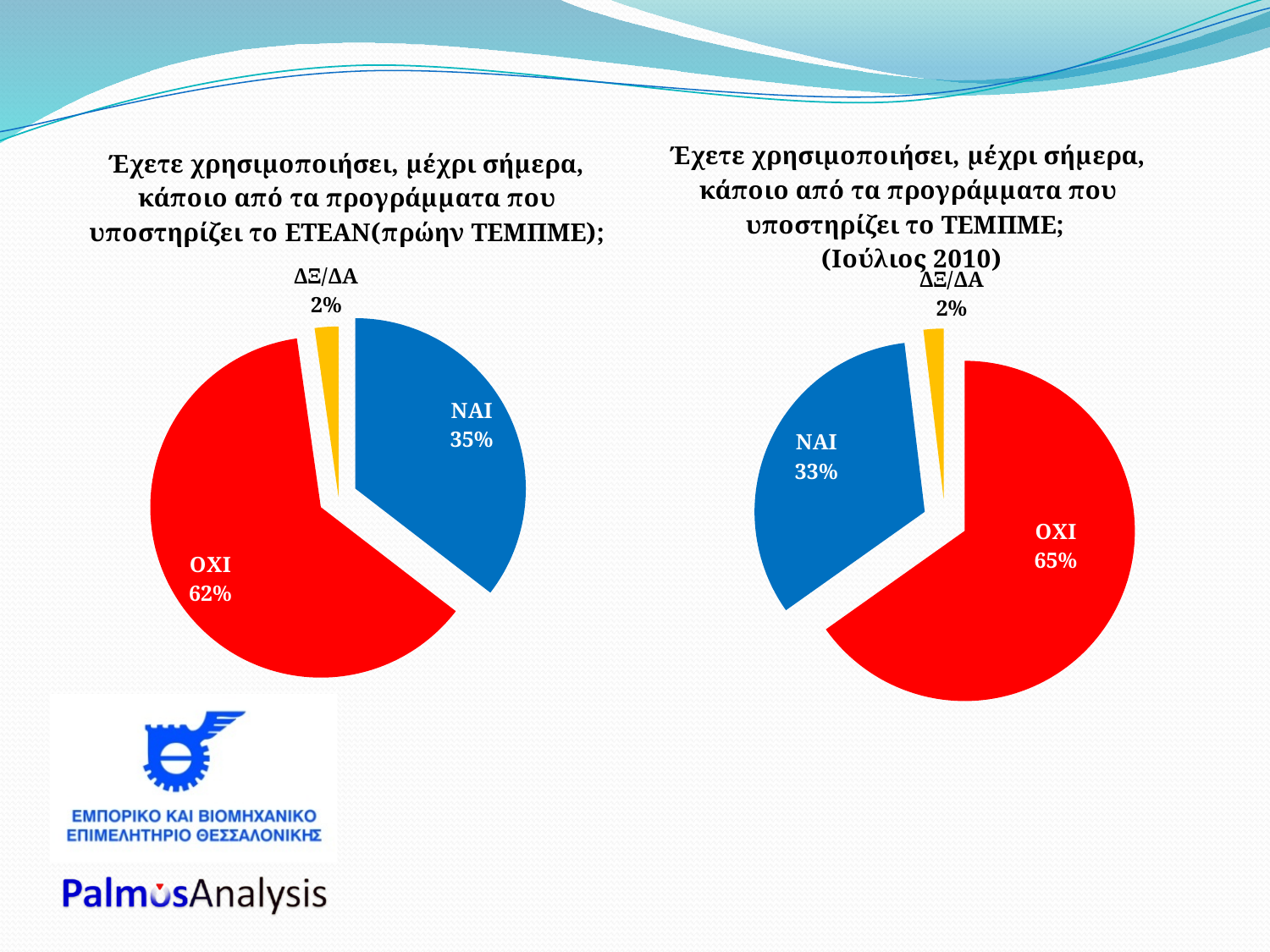
In the left pie chart (ETEAN, πρώην ΤΕΜΠΜΕ), what percentage is shown for ΝΑΙ? 35% In the right pie chart (ΤΕΜΠΜΕ, Ιούλιος 2010), what is the difference between the ΟΧΙ and ΝΑΙ shares? 32% In the right pie chart (ΤΕΜΠΜΕ, Ιούλιος 2010), which category has the smallest share? ΔΞ/ΔΑ Which chart shows a larger ΝΑΙ share, the left chart (ETEAN) or the right chart (ΤΕΜΠΜΕ, Ιούλιος 2010)? the left chart (ETEAN) In the left pie chart (ETEAN, πρώην ΤΕΜΠΜΕ), what is the difference between the ΟΧΙ and ΝΑΙ shares? 27% How many slices does the left pie chart (ETEAN, πρώην ΤΕΜΠΜΕ) have? 3 In the left pie chart (ETEAN, πρώην ΤΕΜΠΜΕ), which category has the largest share? ΟΧΙ In the right pie chart (ΤΕΜΠΜΕ, Ιούλιος 2010), what percentage is shown for ΟΧΙ? 65% In the right pie chart (ΤΕΜΠΜΕ, Ιούλιος 2010), what percentage is shown for ΝΑΙ? 33% What type of chart is used on the right side of the slide (ΤΕΜΠΜΕ, Ιούλιος 2010)? pie chart In the left pie chart (ETEAN, πρώην ΤΕΜΠΜΕ), what percentage is shown for ΟΧΙ? 62% In the right pie chart (ΤΕΜΠΜΕ, Ιούλιος 2010), what colour is the ΟΧΙ slice? red